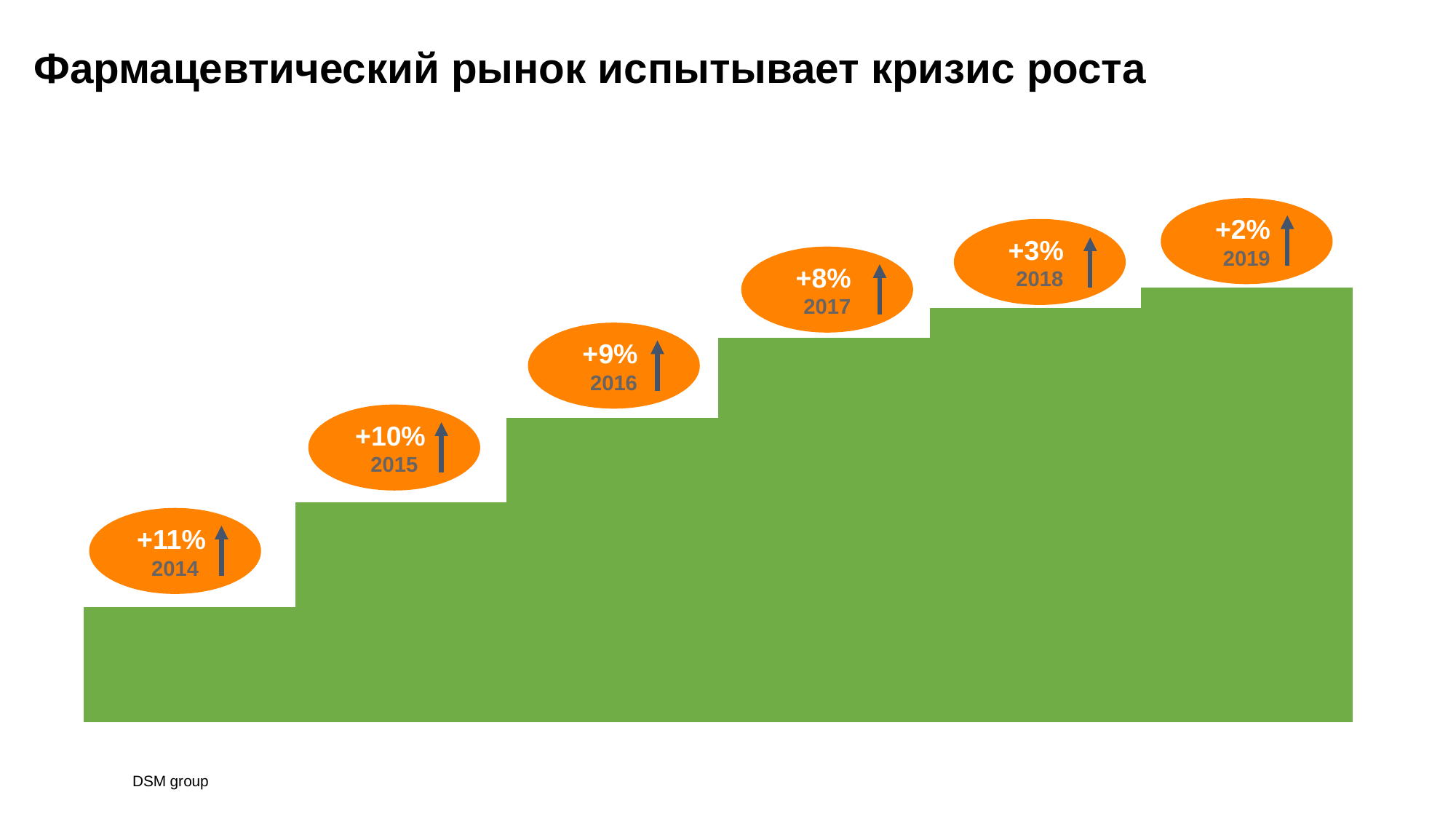
What is the difference in percentage points between the growth rates for 2017 and 2018? 5 percentage points What is the growth rate shown for 2017? +8% How many years are shown on the chart? 6 What is the growth rate shown for 2014? +11% What is the growth rate shown for 2019? +2% What is the difference in percentage points between the growth rates for 2014 and 2019? 9 percentage points Which year has the highest growth rate? 2014 Do the labelled growth rates rise or fall from 2014 to 2019? Fall What is the title of the slide? Фармацевтический рынок испытывает кризис роста Which year has a higher growth rate, 2015 or 2016? 2015 Which year has the lowest growth rate? 2019 What is the growth rate shown for 2018? +3%